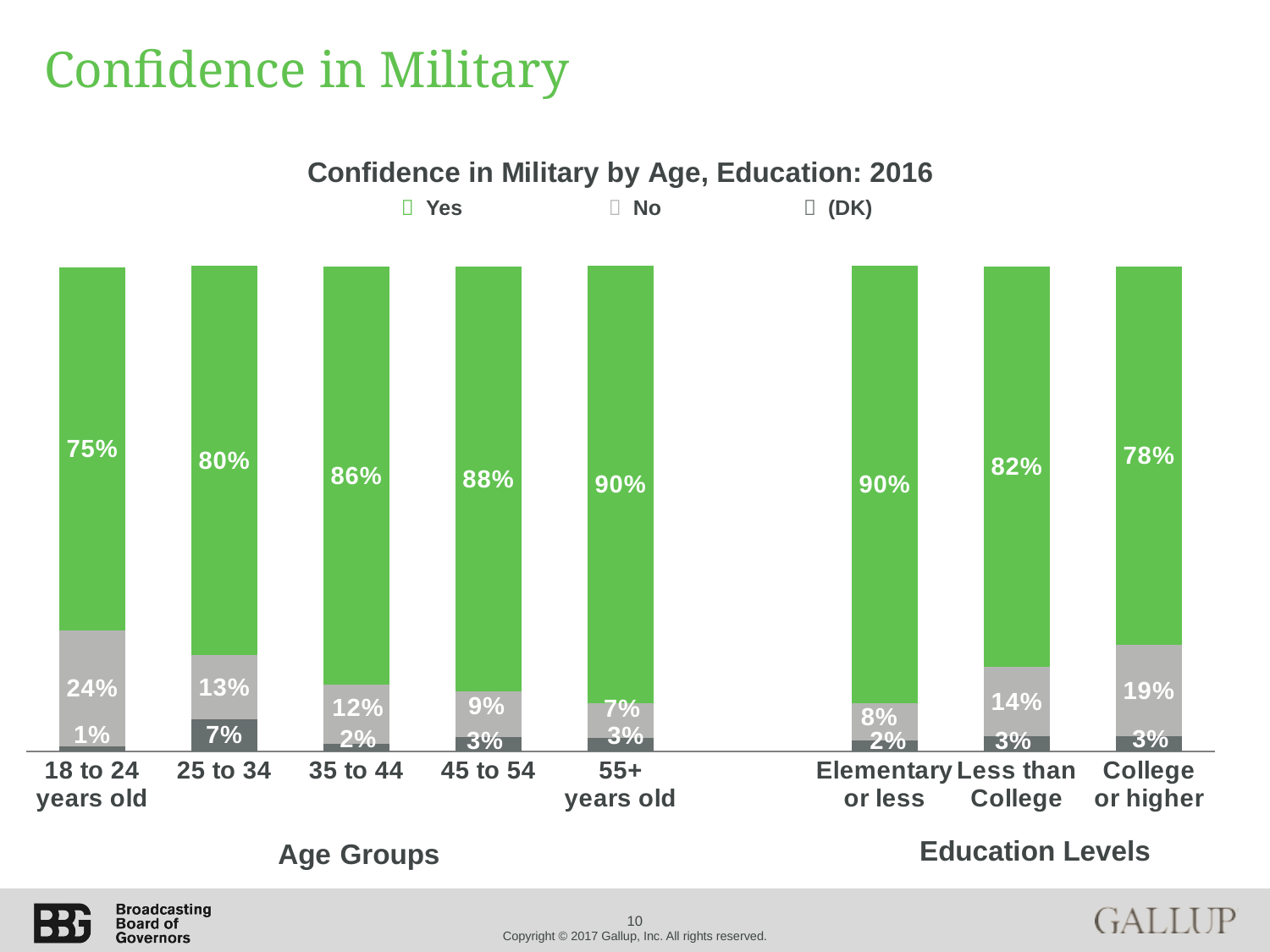
What is the "Yes" value for the 18 to 24 years old age group? 75% How many categories are shown on the x axis in total? 8 Which education level has the lowest "Yes" value? College or higher What is the difference between the "Yes" values for the 55+ years old and 18 to 24 years old age groups? 15% Do the "Yes" values rise or fall as the age groups get older? Rise How many series does the legend list? 3 Which age group has the highest "Yes" value? 55+ years old What is the title of the chart? Confidence in Military by Age, Education: 2016 What is the "No" value for the College or higher education level? 19% Which has a larger "No" value: 18 to 24 years old or 25 to 34? 18 to 24 years old What kind of chart is shown on the slide? Stacked bar chart What is the "(DK)" value for the 25 to 34 age group? 7%